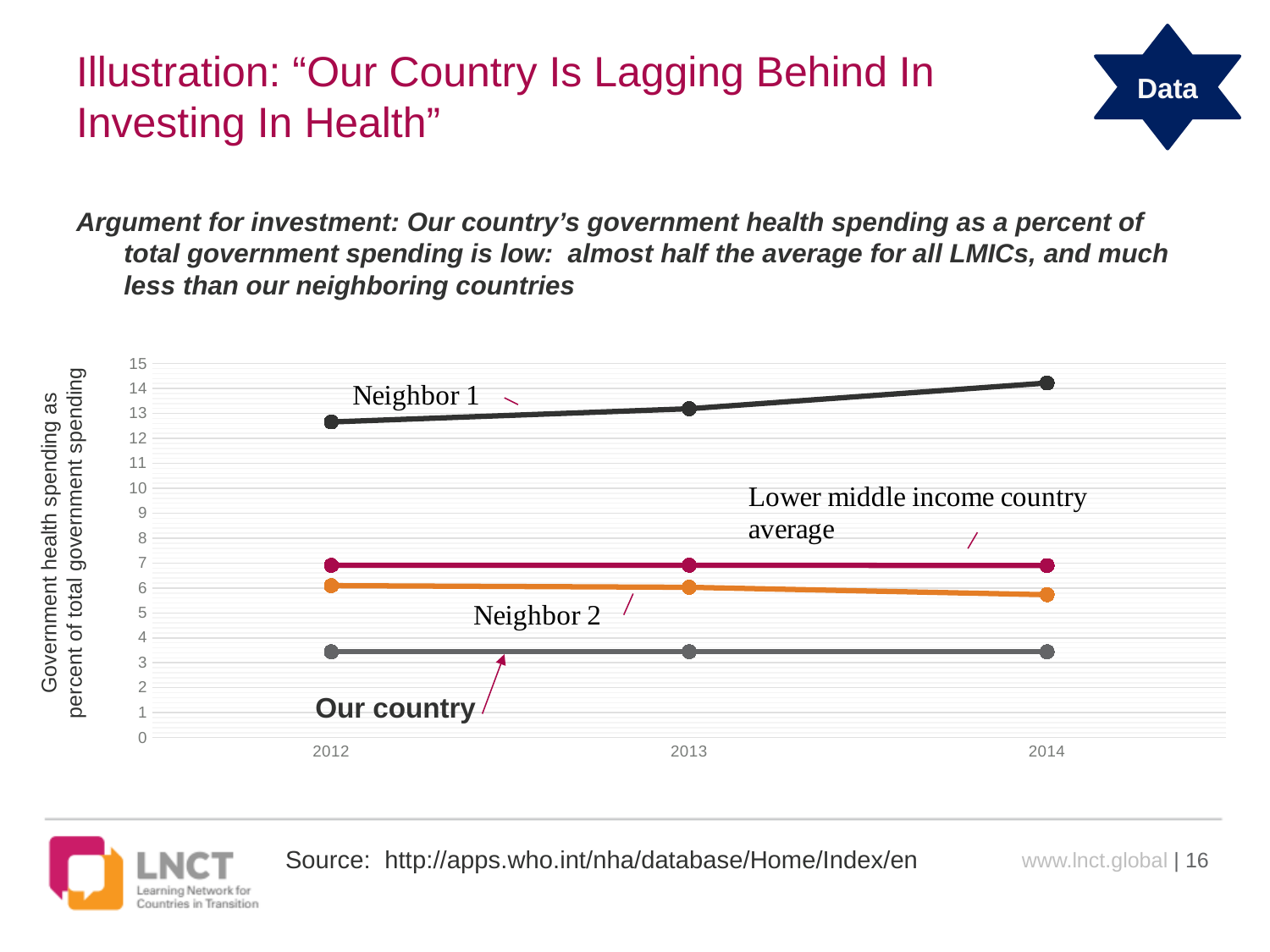
How many lines (series) are plotted on the chart? 4 Does the line for Neighbor 1 rise or fall from 2012 to 2014? Rises How many years are shown on the x axis of the chart? 3 What kind of chart is shown on the slide? Line chart Is the value for Our country in 2013 greater or less than 4? less Which series has the lowest values across all years? Our country Is the value for Neighbor 2 in 2012 greater or less than 5? greater Is the value for Neighbor 1 in 2012 greater or less than 12? greater Which series has the highest values across all years? Neighbor 1 What is the label on the y axis of the chart? Government health spending as percent of total government spending In 2014, which is larger: Neighbor 2 or the Lower middle income country average? Lower middle income country average